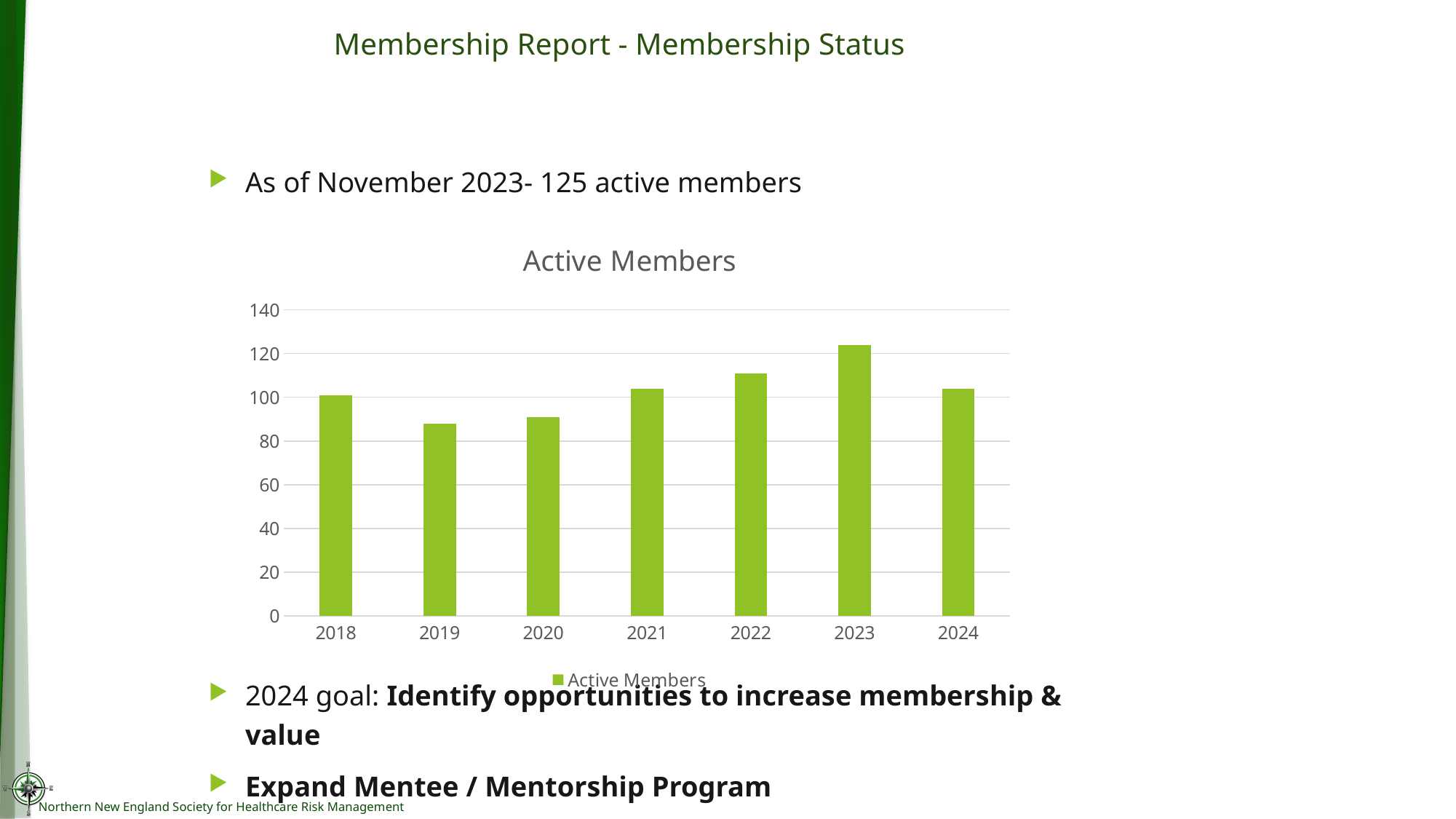
Which year has more active members, 2022 or 2018? 2022 Which year has the lowest number of active members? 2019 Which year has the highest number of active members? 2023 How many years are shown on the x axis of the chart? 7 Is the value for 2020 greater or less than 100? less Is the value for 2023 greater or less than 100? greater Is the value for 2019 greater or less than 100? less What kind of chart is shown on the slide? Bar chart What is the title of the chart? Active Members Do the values rise or fall from 2019 to 2023? Rise How many series does the chart legend list? 1